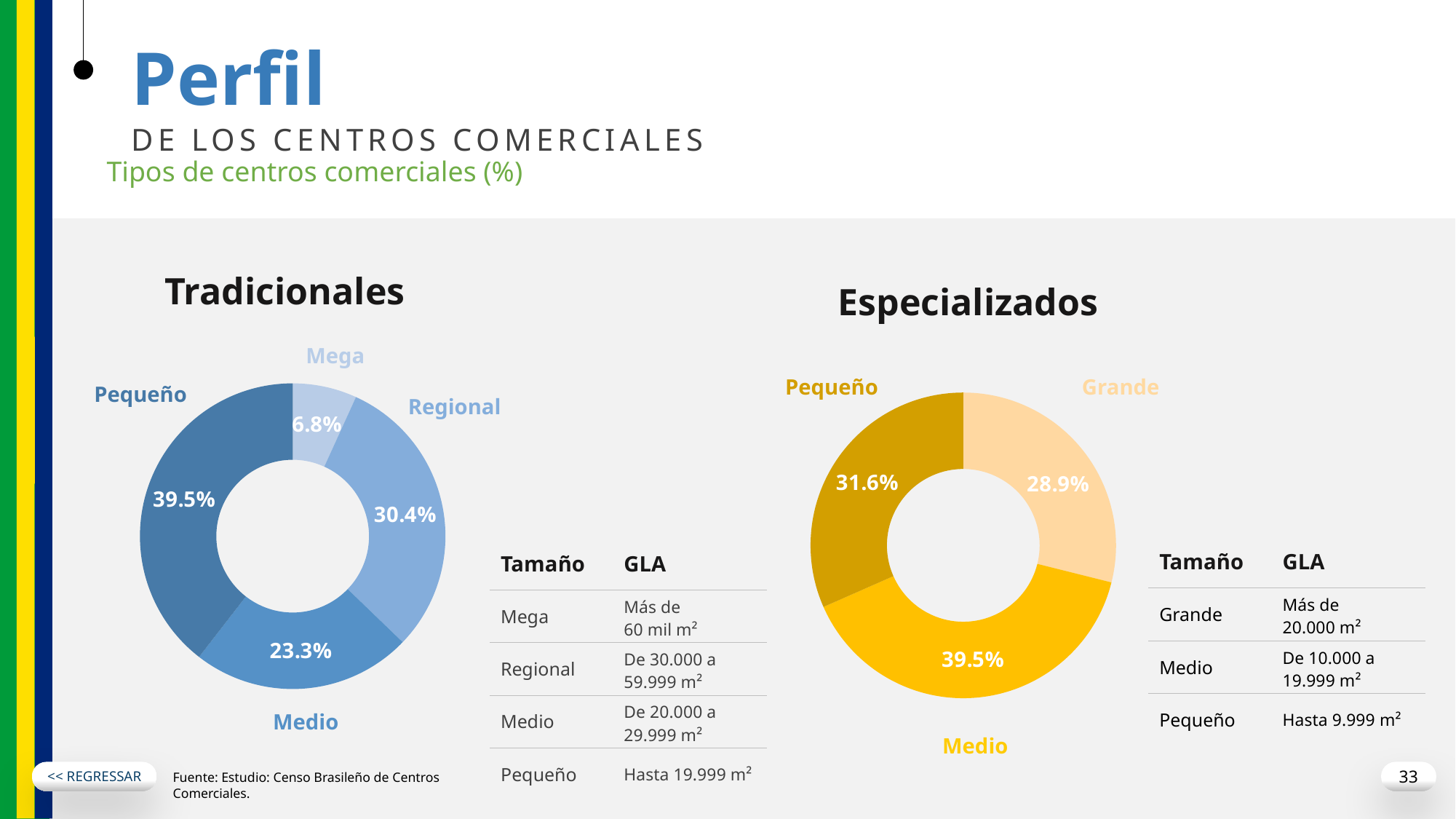
In the Tradicionales chart, what is the difference in percentage points between Regional and Medio? 7.1 What type of chart is used for Especializados? Donut (pie) chart In the Tradicionales chart, what percentage is shown for Pequeño? 39.5% In the Especializados chart, what percentage is shown for Grande? 28.9% In the Tradicionales chart, which is larger: Regional or Medio? Regional In the Tradicionales chart, which category has the smallest share? Mega In the Especializados chart, which category has the largest share? Medio How many categories are shown in the Especializados chart? 3 In the Tradicionales chart, what percentage is shown for Mega? 6.8% In the Especializados chart, what is the difference in percentage points between Medio and Pequeño? 7.9 In the Especializados chart, what colour is the Medio slice? Yellow How many categories are shown in the Tradicionales chart? 4